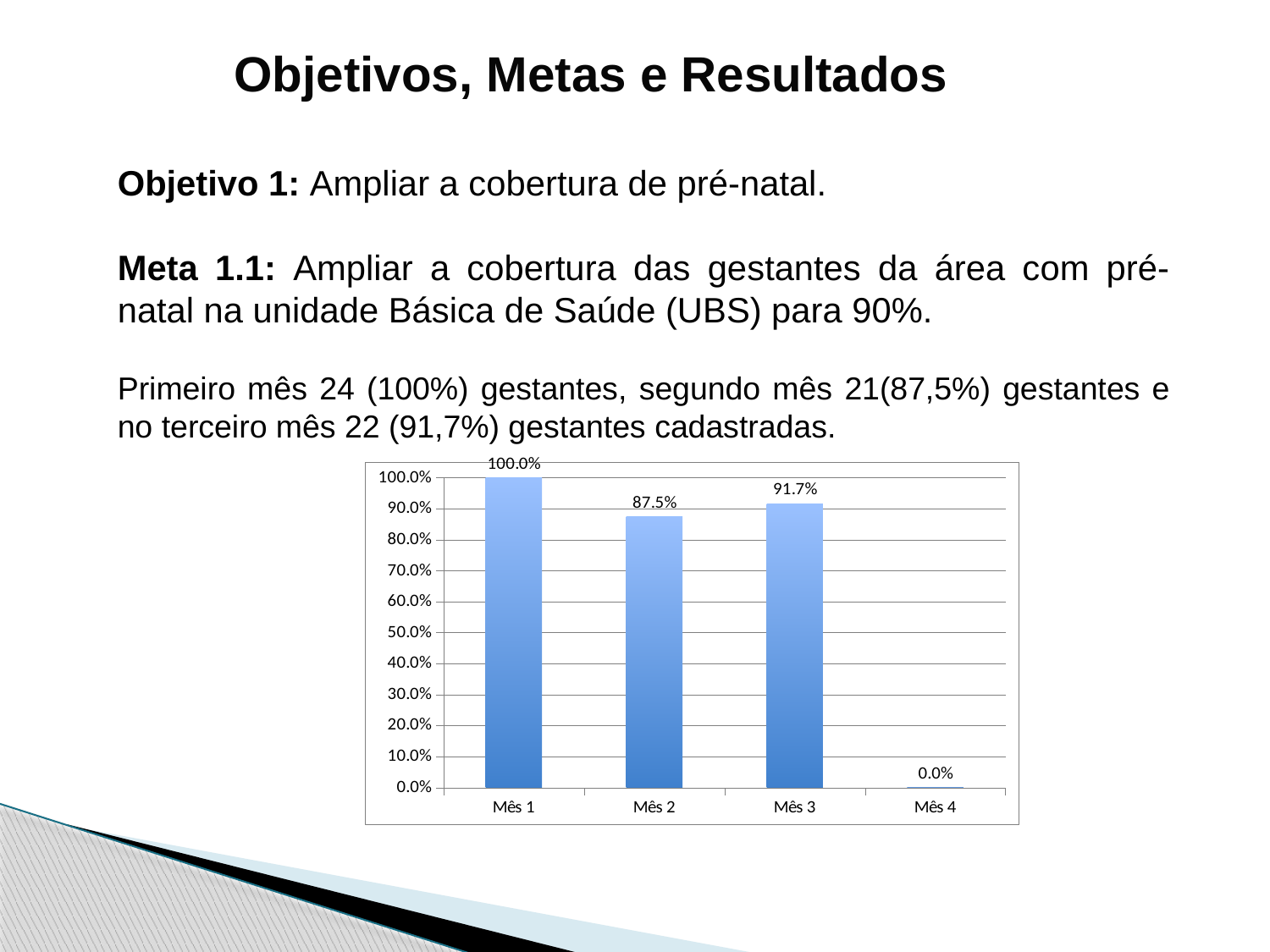
What is the difference between the values for Mês 3 and Mês 2? 4.2% What is the value for Mês 1? 100.0% What is the difference between the values for Mês 1 and Mês 2? 12.5% How many categories are shown on the x axis? 4 Which category has the highest value? Mês 1 What is the value for Mês 2? 87.5% What is the value for Mês 3? 91.7% Which category has the lowest value? Mês 4 What is the value for Mês 4? 0.0% Which is larger, the value for Mês 2 or the value for Mês 3? Mês 3 What kind of chart is shown on the slide? bar chart Is the value for Mês 2 greater or less than 90.0%? less